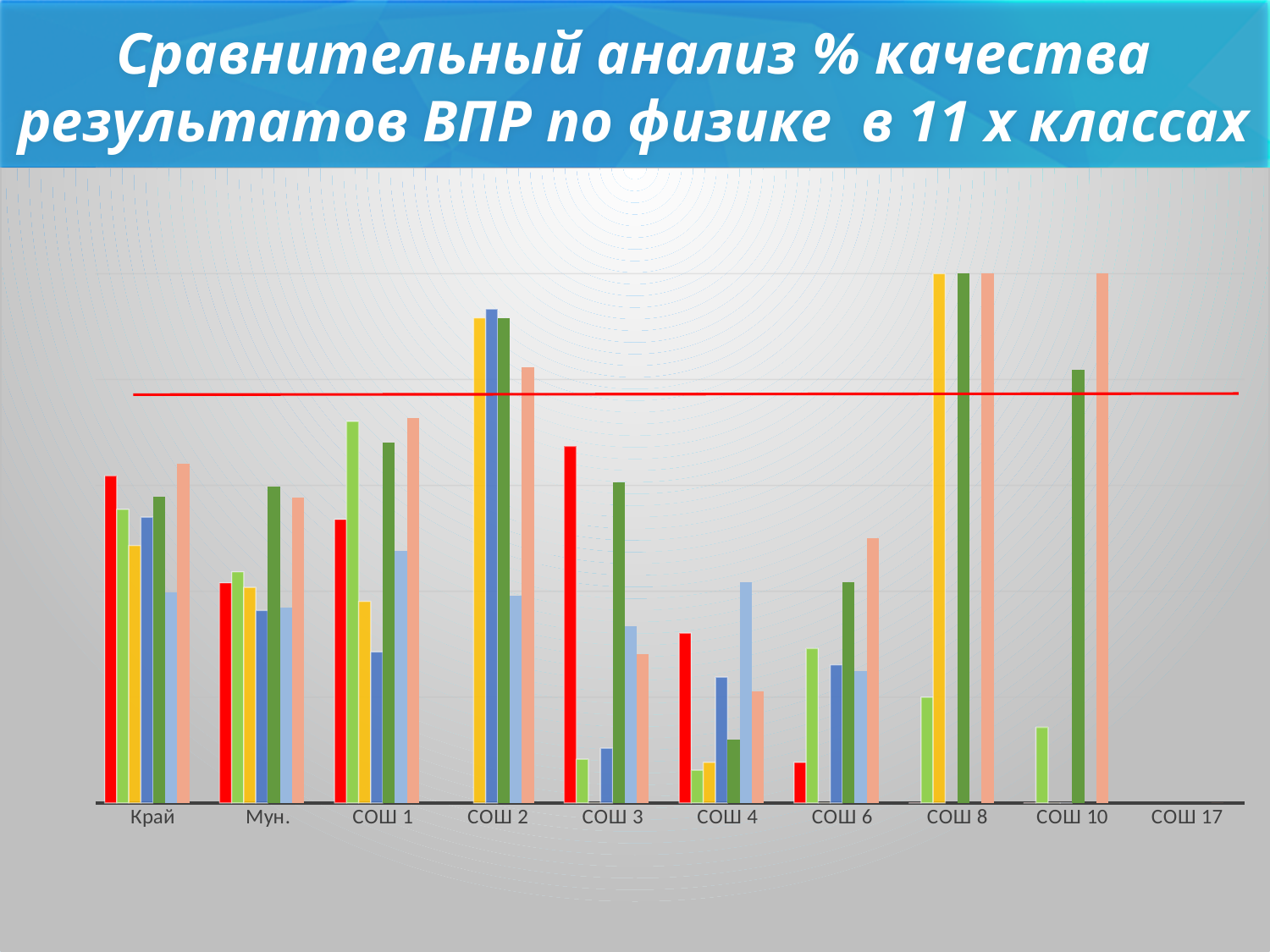
Which is larger: the light green bar for СОШ 1 or the light green bar for СОШ 3? СОШ 1 Which is larger: the red bar for Край or the red bar for СОШ 6? Край Which is larger: the yellow bar for СОШ 8 or the yellow bar for СОШ 4? СОШ 8 What is the title of the slide's chart? Сравнительный анализ % качества результатов ВПР по физике в 11 х классах How many categories are shown along the x axis of the chart? 10 Which category has the tallest dark blue bar? СОШ 2 Which category on the x axis has no bars plotted at all? СОШ 17 Which category has the tallest light green bar? СОШ 1 Among the categories that have a red bar, which one has the shortest red bar? СОШ 6 Which category has the tallest dark green bar? СОШ 8 What kind of chart is shown on the slide? bar chart